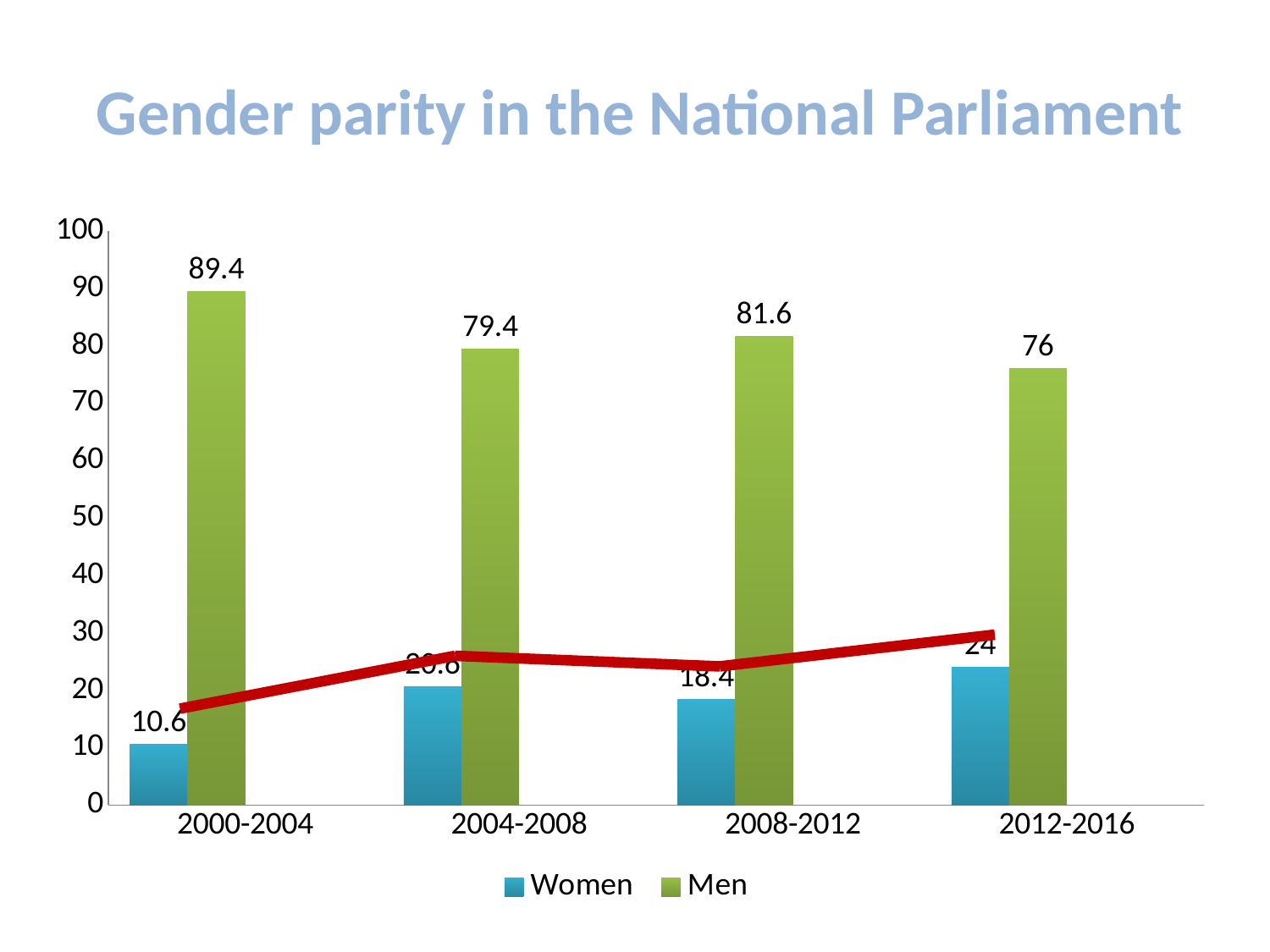
What is the value for Women in 2012-2016? 24 How many series does the legend list? 2 In which period is the value for Men the highest? 2000-2004 Which is larger, the Men value in 2004-2008 or the Men value in 2008-2012? 2008-2012 What is the value for Women in 2000-2004? 10.6 What is the value for Men in 2012-2016? 76 Is the value for Women in 2004-2008 greater or less than 30? less How many periods are shown on the x axis? 4 In which period is the value for Women the lowest? 2000-2004 What is the value for Women in 2008-2012? 18.4 What is the difference between the Men and Women values in 2012-2016? 52 What is the value for Men in 2000-2004? 89.4